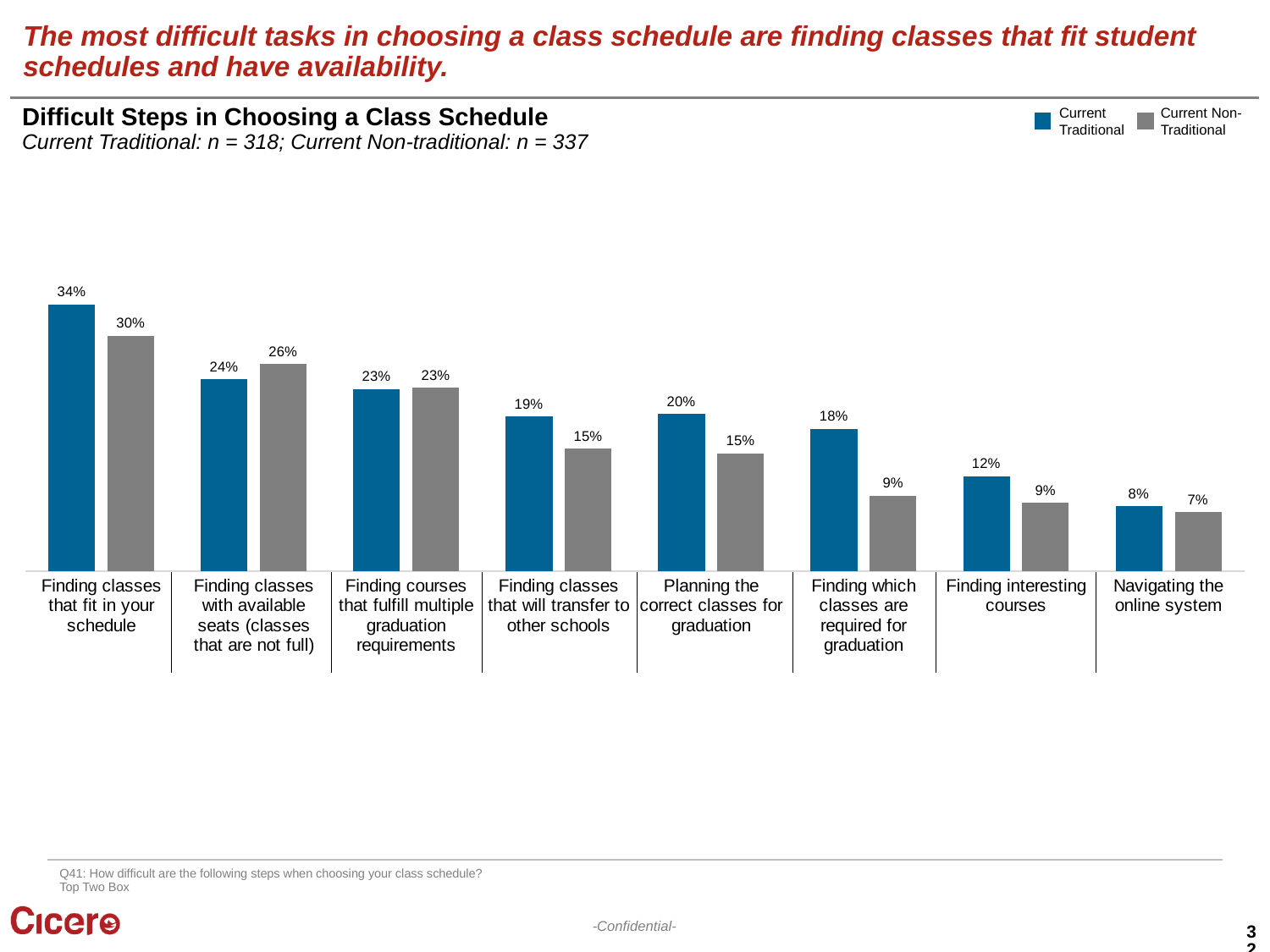
Do the Current Traditional values generally rise or fall from left to right across the categories? Fall How many categories are shown on the x axis? 8 What is the sample size (n) for Current Non-traditional students shown in the chart subtitle? 337 For 'Finding classes that will transfer to other schools', which group has the larger value, Current Traditional or Current Non-Traditional? Current Traditional What is the difference between the Current Traditional and Current Non-Traditional values for 'Finding which classes are required for graduation'? 9% What kind of chart is shown on the slide? Bar chart What percentage of Current Traditional students find 'Finding classes that fit in your schedule' difficult? 34% What is the Current Non-Traditional value for 'Planning the correct classes for graduation'? 15% Which category has the highest Current Traditional value? Finding classes that fit in your schedule Which category has the lowest Current Non-Traditional value? Navigating the online system How many series does the legend list? 2 What is the Current Non-Traditional value for 'Finding classes with available seats (classes that are not full)'? 26%